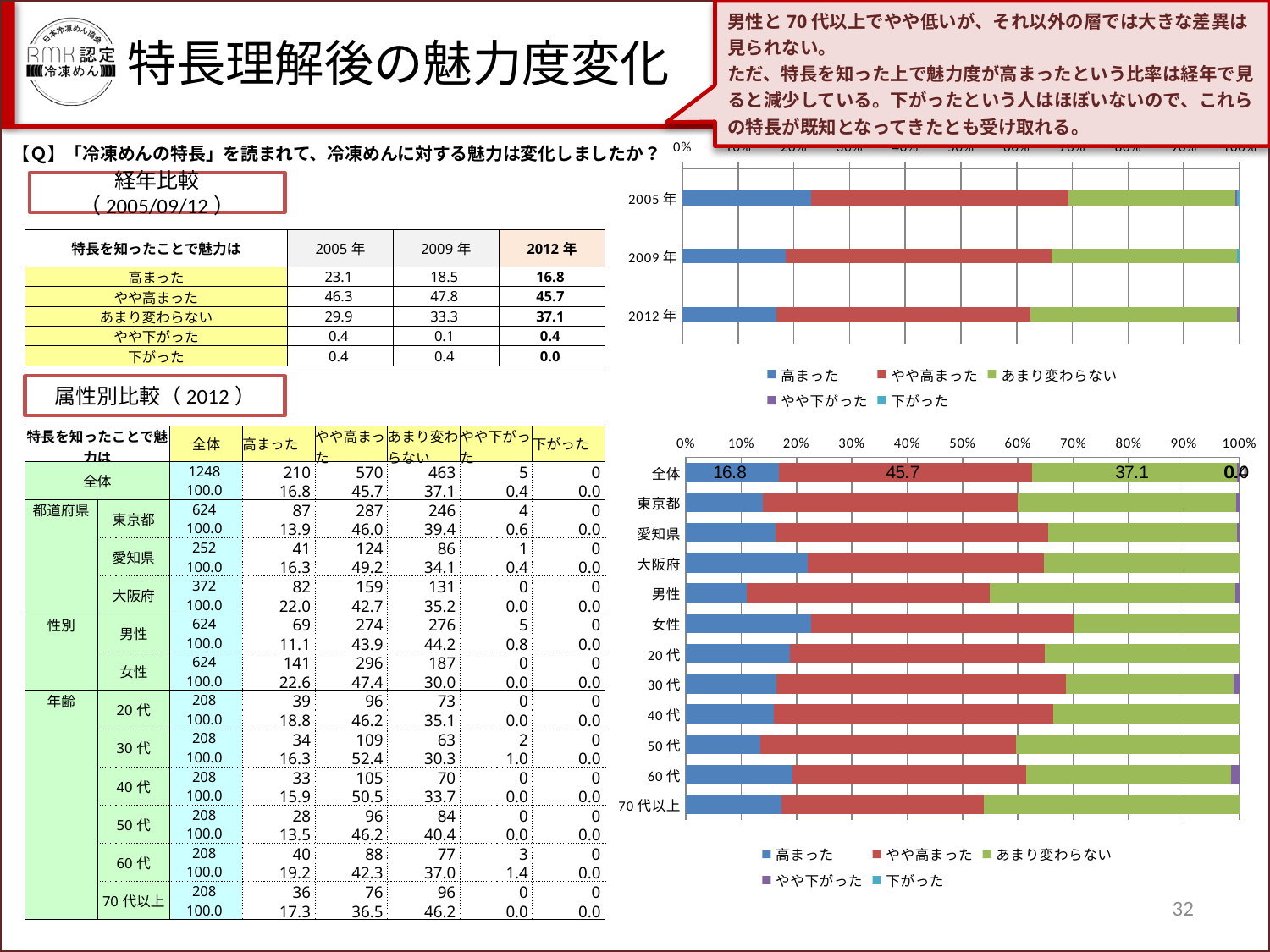
In the bottom-right chart, what is the value of 高まった for 全体? 16.8 In the bottom-right chart, is the 高まった segment larger for 女性 or for 男性? 女性 In the bottom-right chart, what is the value of やや高まった for 全体? 45.7 In the top-right chart, is the 高まった segment larger for 2005年 or for 2012年? 2005年 In the top-right chart, does the 高まった segment rise or fall from 2005年 to 2012年? Fall In the bottom-right chart, is the 高まった value for 男性 greater or less than 20%? less How many categories are plotted on the vertical axis of the bottom-right chart? 12 In the bottom-right chart, what is the value of あまり変わらない for 全体? 37.1 In the bottom-right chart, what is the difference between やや高まった and 高まった for 全体? 28.9 How many categories (years) are plotted in the top-right chart? 3 How many series does the legend of the top-right chart list? 5 What kind of chart is the top-right chart comparing 2005年, 2009年 and 2012年? Stacked bar chart